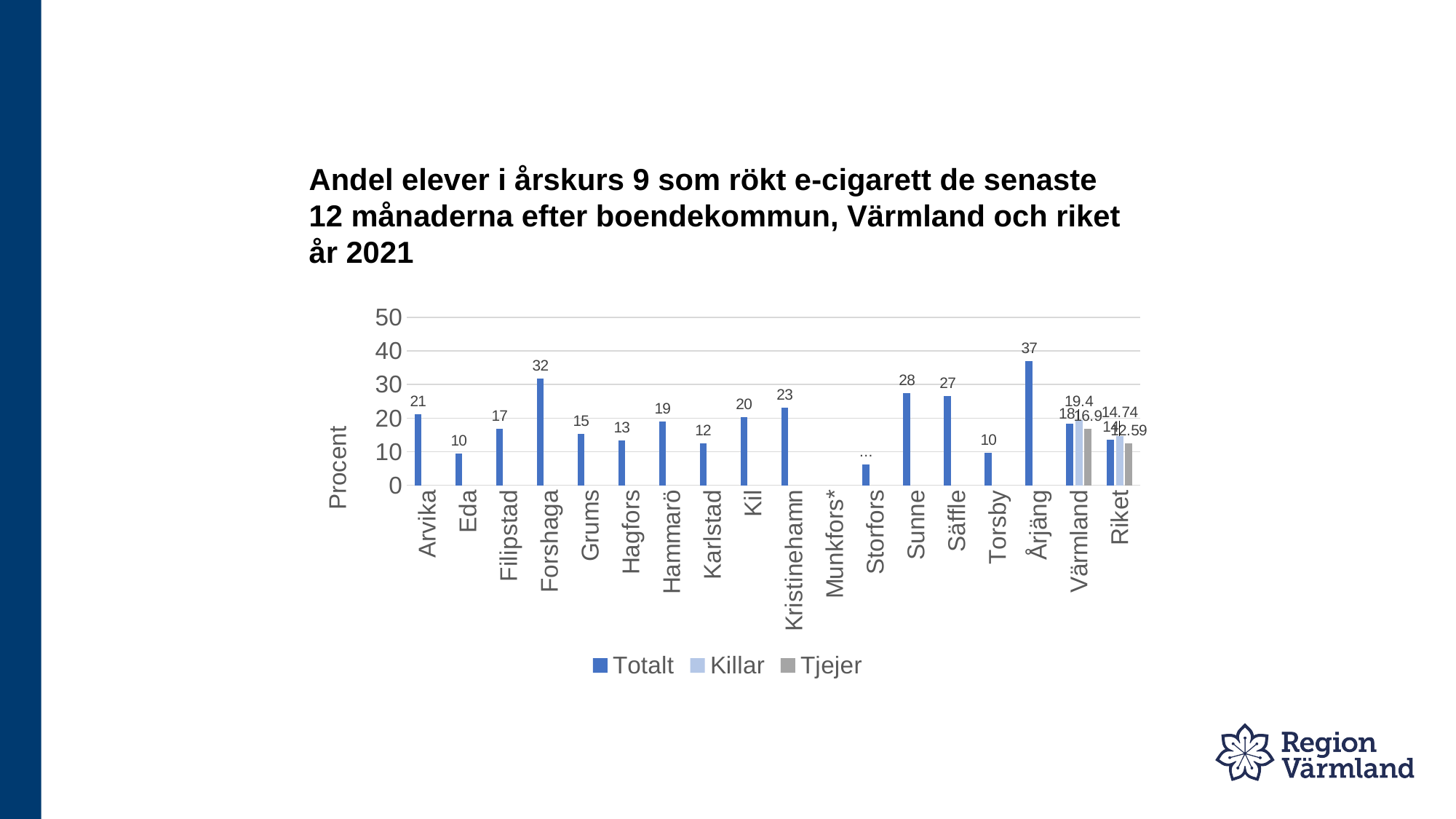
What is the Killar value for Värmland? 19.4 What is the Tjejer value for Riket? 12.59 What kind of chart is shown on the slide? bar chart How many series does the legend list? 3 What is the difference between the Totalt values for Årjäng and Forshaga? 5 What is the label on the y axis? Procent Which municipality has the highest Totalt value? Årjäng What is the Totalt value for Kristinehamn? 23 Is the Totalt value for Storfors greater or less than 10? less Which has a higher Totalt value, Sunne or Säffle? Sunne How many categories are shown on the x axis? 18 What is the Totalt value for Forshaga? 32